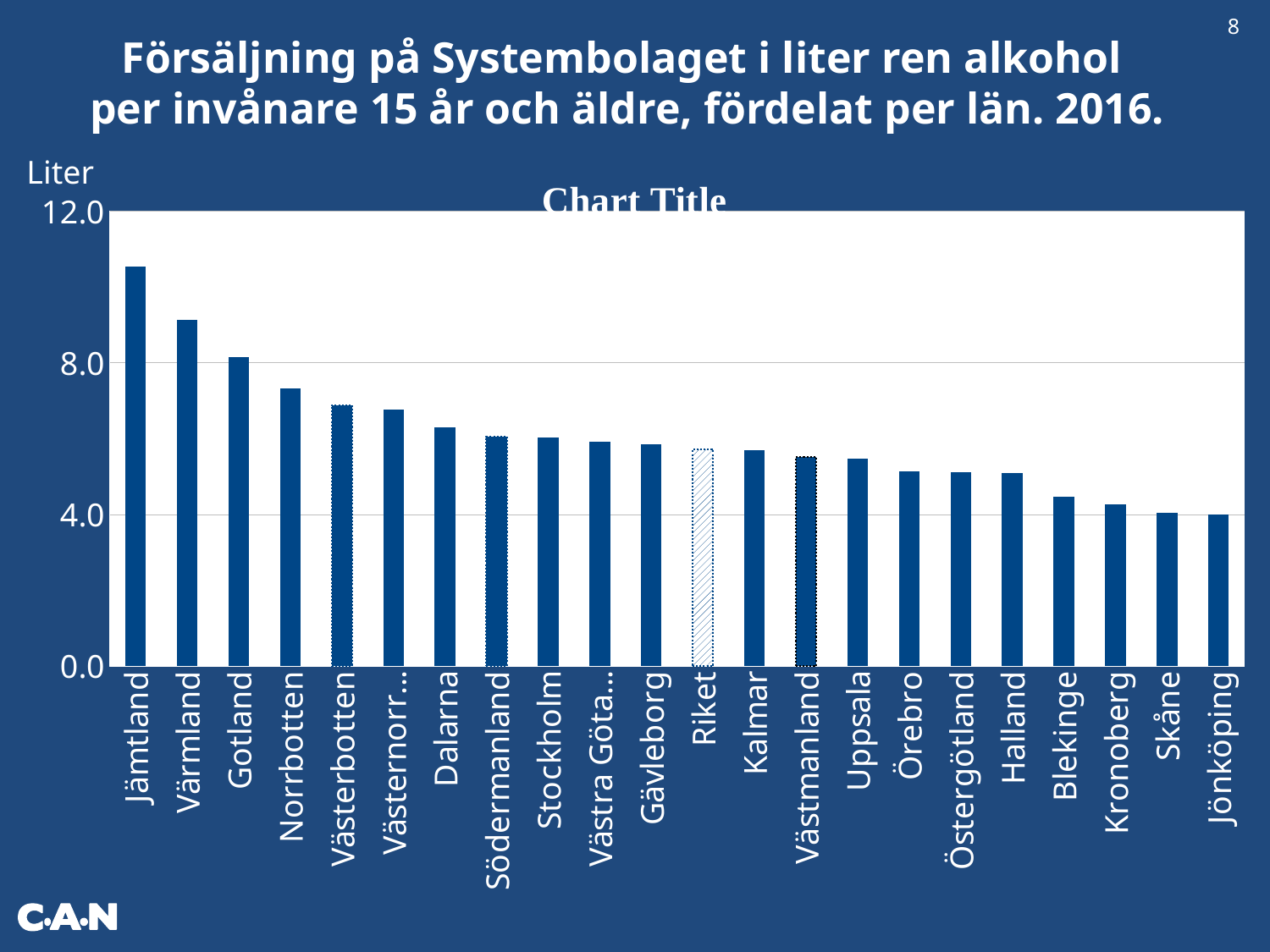
Is the value for Värmland greater or less than 8.0? greater Which category has the highest value on the chart? Jämtland Is the value for Norrbotten greater or less than 8.0? less Do the values rise or fall from left to right along the x axis? fall Which is larger, the value for Jämtland or the value for Värmland? Jämtland How many categories (bars) are shown on the chart? 22 Which is larger, the value for Gotland or the value for Halland? Gotland Is the value for Riket greater or less than 8.0? less What kind of chart is shown on the slide? bar chart What label is shown on the vertical axis of the chart? Liter